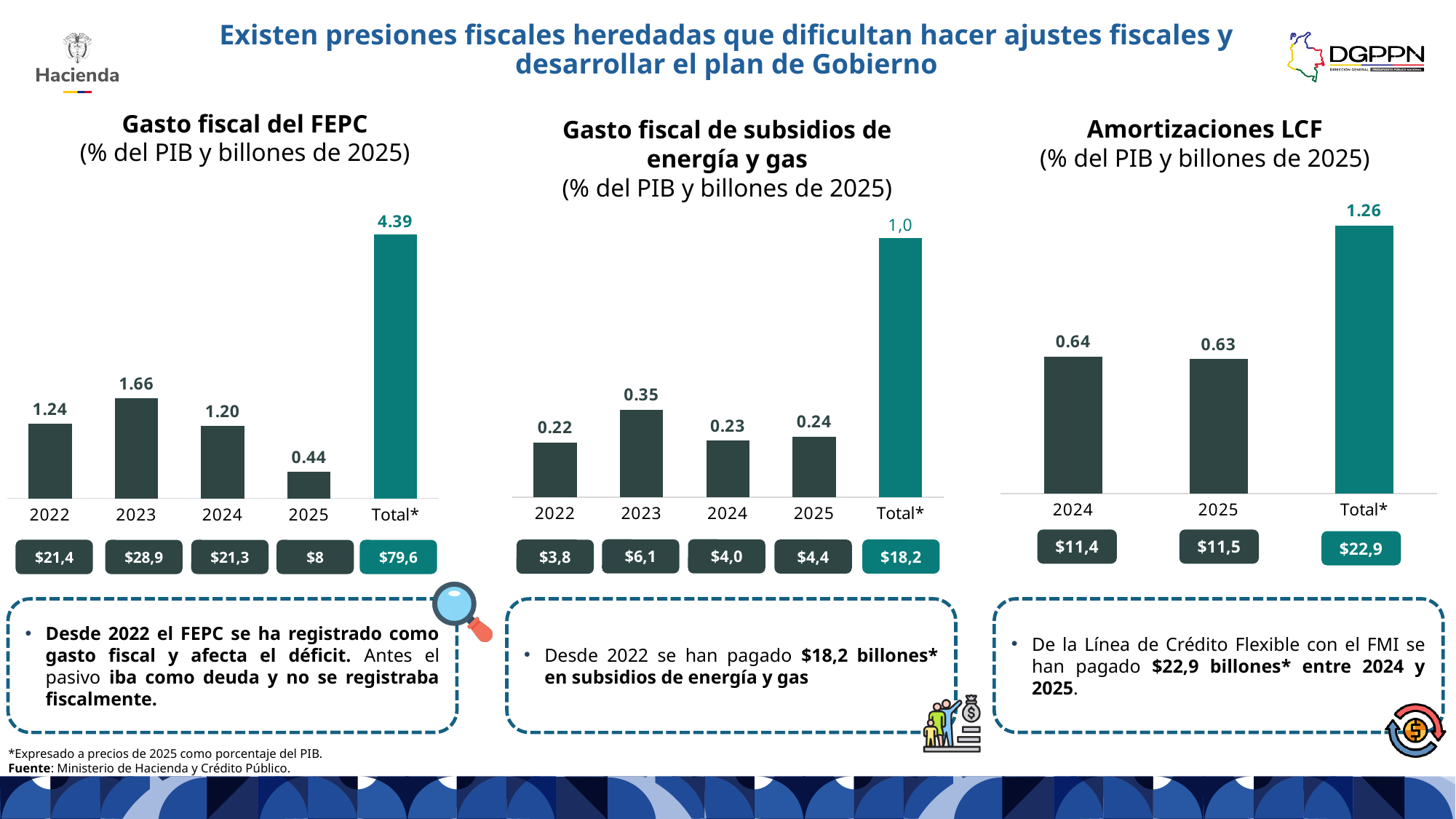
In the 'Gasto fiscal del FEPC' chart, which year among 2022–2025 has the lowest value? 2025 In the 'Gasto fiscal del FEPC' chart, what is the difference between the 2023 value and the 2025 value? 1.22 In the 'Amortizaciones LCF' chart, what is the value shown for Total*? 1.26 In the 'Gasto fiscal de subsidios de energía y gas' chart, which year among 2022–2025 has the highest value? 2023 In the 'Amortizaciones LCF' chart, what is the value for 2024? 0.64 In the 'Gasto fiscal del FEPC' chart, what is the value for 2023? 1.66 In the 'Gasto fiscal de subsidios de energía y gas' chart, how many bars are plotted? 5 In the 'Gasto fiscal de subsidios de energía y gas' chart, what is the value for 2024? 0.23 In the 'Gasto fiscal del FEPC' chart, is the value for 2022 larger or smaller than the value for 2024? larger In the 'Gasto fiscal de subsidios de energía y gas' chart, what is the difference between the 2023 value and the 2022 value? 0.13 What kind of chart is the 'Amortizaciones LCF' chart? bar chart In the 'Gasto fiscal del FEPC' chart, what is the value shown for Total*? 4.39